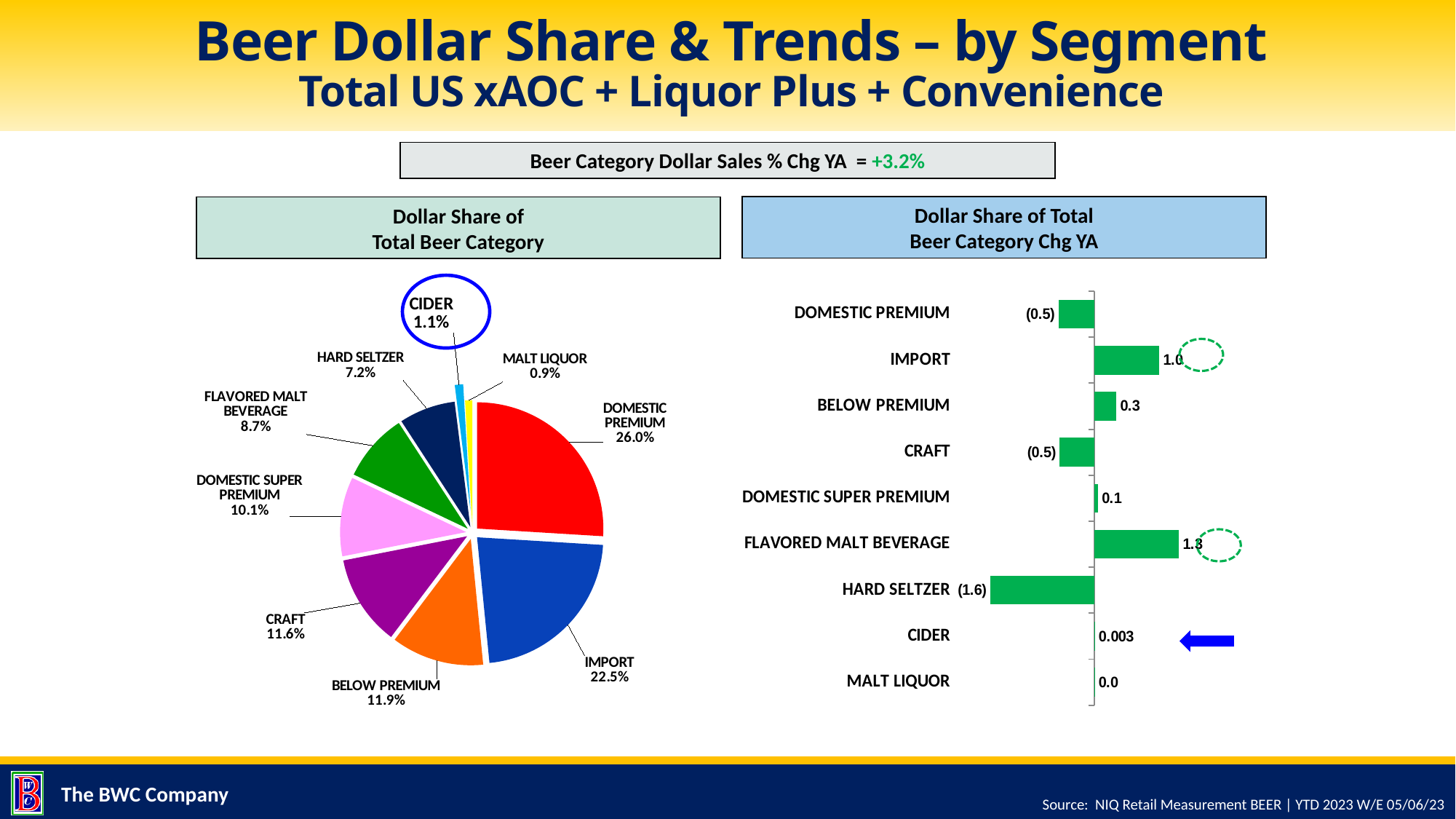
In the Dollar Share of Total Beer Category pie chart, what is the share for Domestic Premium? 26.0% In the Dollar Share of Total Beer Category pie chart, which segment has the smallest share? Malt Liquor In the Dollar Share of Total Beer Category pie chart, how many segments are shown? 9 In the Dollar Share of Total Beer Category Chg YA chart, what is the value for Hard Seltzer? (1.6) In the Dollar Share of Total Beer Category pie chart, which segment has the largest share? Domestic Premium In the Dollar Share of Total Beer Category Chg YA chart, which segment has the highest value? Flavored Malt Beverage What type of chart is the Dollar Share of Total Beer Category Chg YA chart on the right? Bar chart In the Dollar Share of Total Beer Category pie chart, what is the difference between the Domestic Premium and Import shares? 3.5% What type of chart is the Dollar Share of Total Beer Category chart on the left? Pie chart In the Dollar Share of Total Beer Category Chg YA chart, what is the value for Flavored Malt Beverage? 1.3 In the Dollar Share of Total Beer Category pie chart, what is the share for Hard Seltzer? 7.2% In the Dollar Share of Total Beer Category Chg YA chart, which is larger, the value for Import or the value for Below Premium? Import